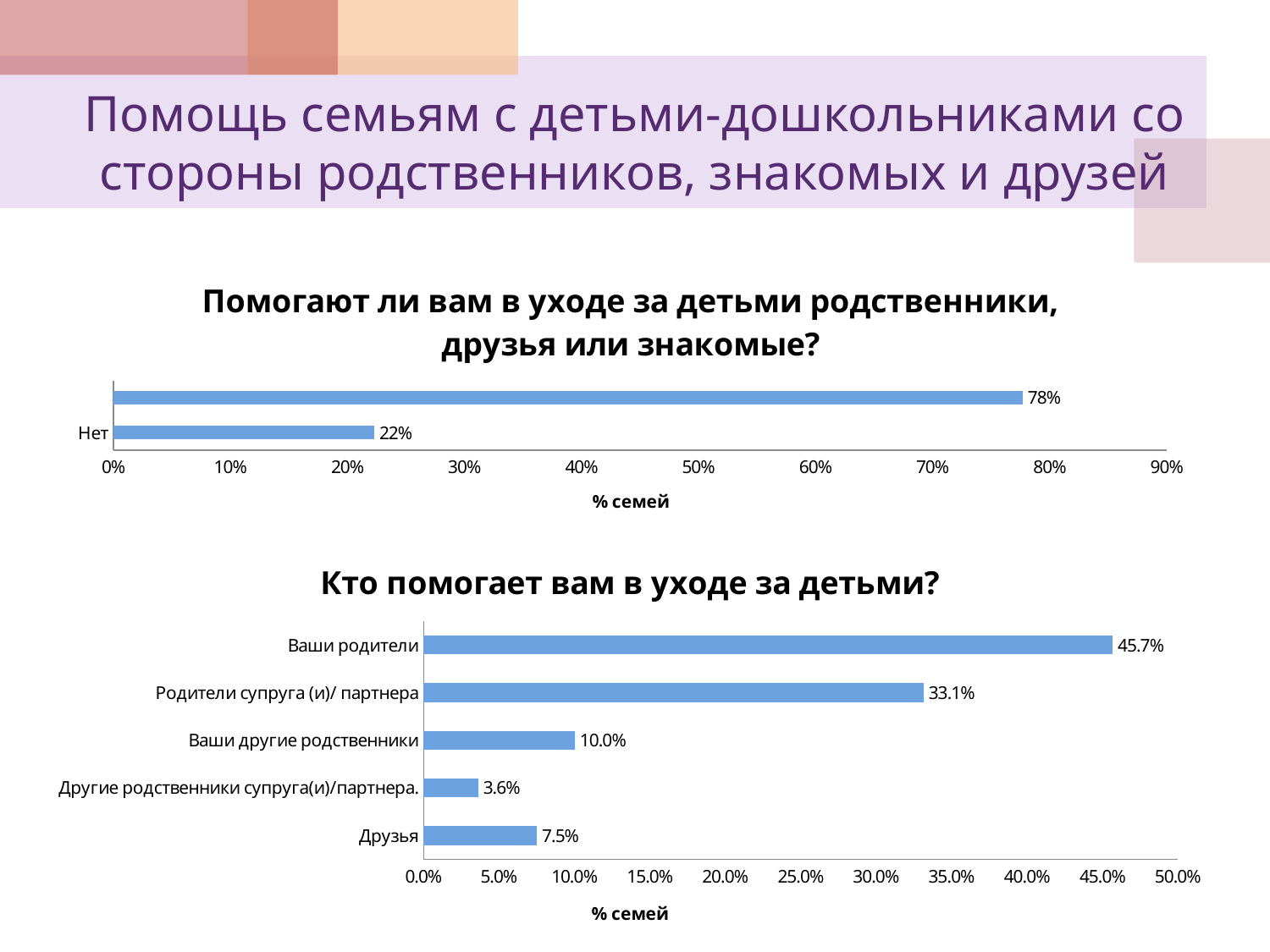
In the chart 'Кто помогает вам в уходе за детьми?', how many categories are shown? 5 What kind of chart is the top chart 'Помогают ли вам в уходе за детьми родственники, друзья или знакомые?'? bar chart What is the x-axis title of the bottom chart 'Кто помогает вам в уходе за детьми?'? % семей In the chart 'Кто помогает вам в уходе за детьми?', what is the value for 'Ваши родители'? 45.7% In the chart 'Кто помогает вам в уходе за детьми?', what is the difference between 'Ваши родители' and 'Родители супруга (и)/ партнера'? 12.6% In the chart 'Кто помогает вам в уходе за детьми?', is the value for 'Ваши родители' greater or less than 40.0%? greater In the chart 'Кто помогает вам в уходе за детьми?', which category has the lowest value? Другие родственники супруга(и)/партнера. In the chart 'Кто помогает вам в уходе за детьми?', what is the value for 'Друзья'? 7.5% In the chart 'Кто помогает вам в уходе за детьми?', what is the value for 'Родители супруга (и)/ партнера'? 33.1% In the chart 'Кто помогает вам в уходе за детьми?', which is larger: 'Ваши другие родственники' or 'Друзья'? Ваши другие родственники In the chart 'Кто помогает вам в уходе за детьми?', which category has the highest value? Ваши родители In the top chart 'Помогают ли вам в уходе за детьми родственники, друзья или знакомые?', what is the value for 'Нет'? 22%